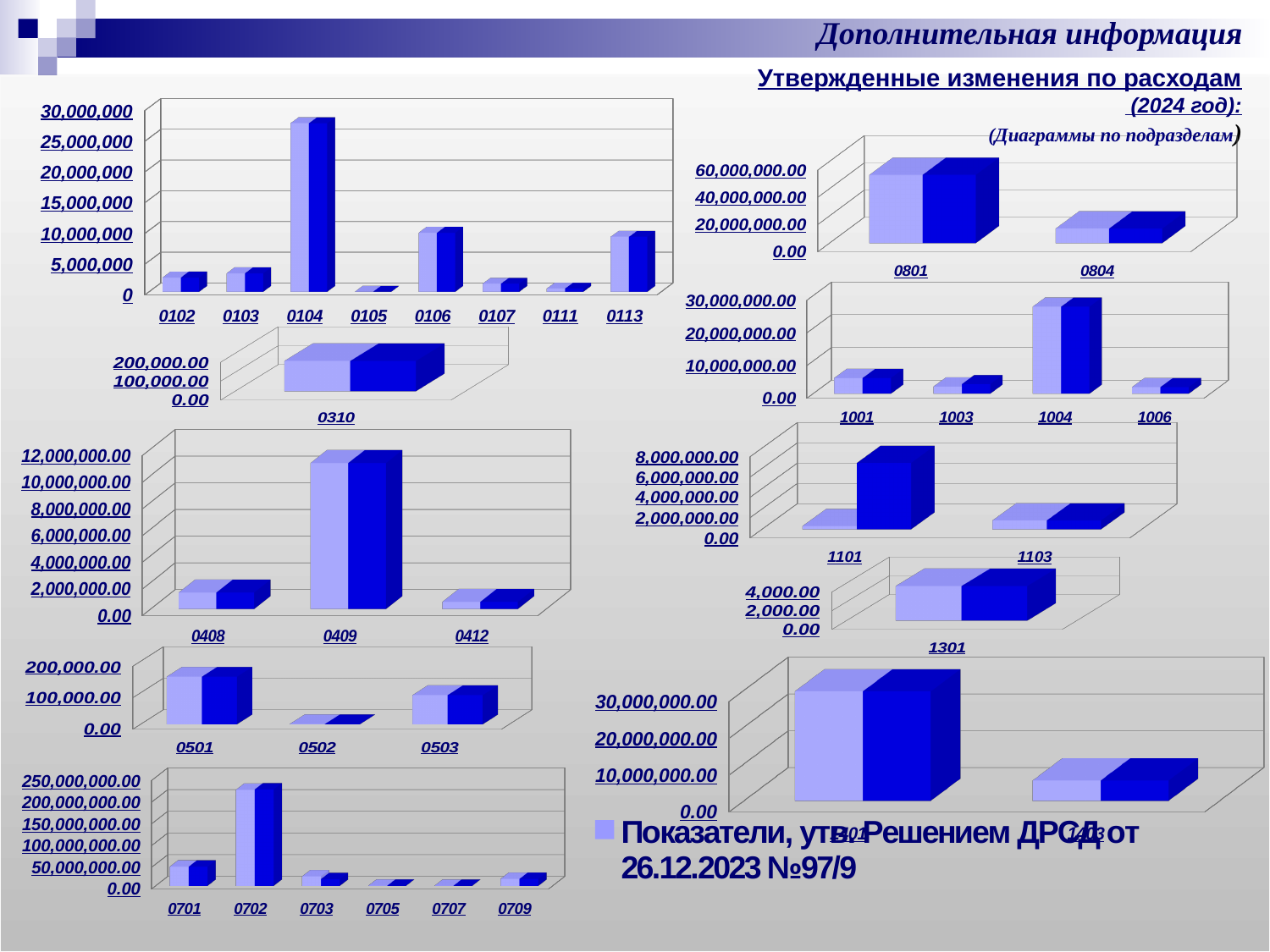
On the chart with categories 0501, 0502 and 0503, which category has the lowest value? 0502 On the chart with categories 1001 to 1006, which category has the highest value? 1004 On the chart with categories 0102 to 0113, which category has the highest value? 0104 On the chart with categories 0801 and 0804, which category has the larger value? 0801 How many categories are shown on the chart with categories 0701 to 0709? 6 On the chart with categories 0408, 0409 and 0412, which category has the highest value? 0409 How many categories are shown on the chart with categories 0102 to 0113? 8 What is the title of the set of charts on the slide? Утвержденные изменения по расходам (2024 год) What kind of chart is the chart with categories 0102 to 0113? bar chart On the chart with categories 0102 to 0113, is the value for 0104 greater or less than 25,000,000? greater On the chart with categories 0408, 0409 and 0412, is the value for 0409 greater or less than 10,000,000.00? greater